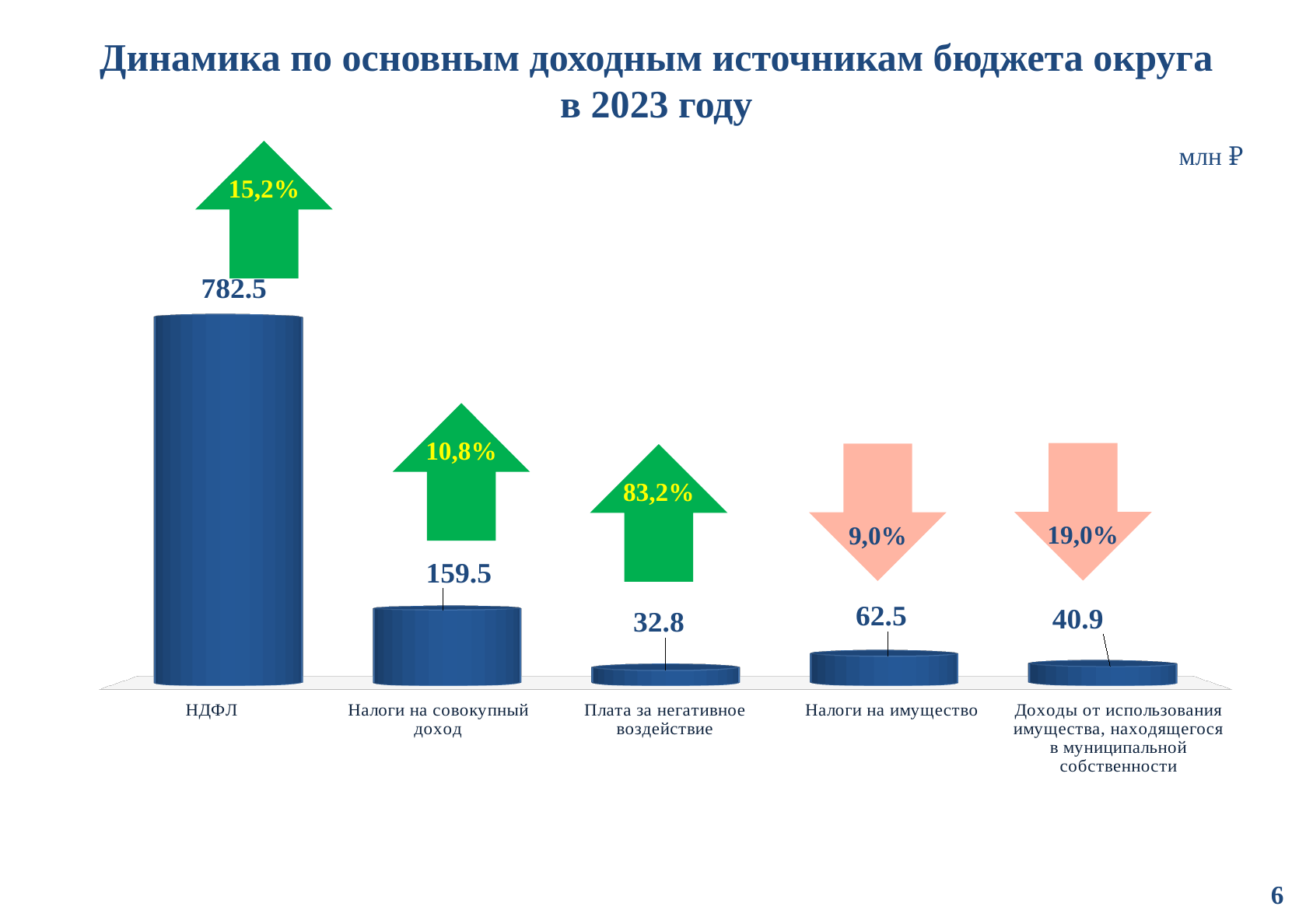
What is the value for Плата за негативное воздействие? 32.8 What type of chart is shown on the slide? Bar chart Which category has the lowest value? Плата за негативное воздействие Which is larger: the value for Налоги на имущество or the value for Плата за негативное воздействие? Налоги на имущество What is the value for НДФЛ? 782.5 What is the difference between the values for Налоги на имущество and Доходы от использования имущества, находящегося в муниципальной собственности? 21.6 How many categories are shown in the chart? 5 Which category has the highest value? НДФЛ What is the value for Налоги на совокупный доход? 159.5 What is the value for Доходы от использования имущества, находящегося в муниципальной собственности? 40.9 What is the difference between the values for НДФЛ and Налоги на совокупный доход? 623.0 What is the value for Налоги на имущество? 62.5